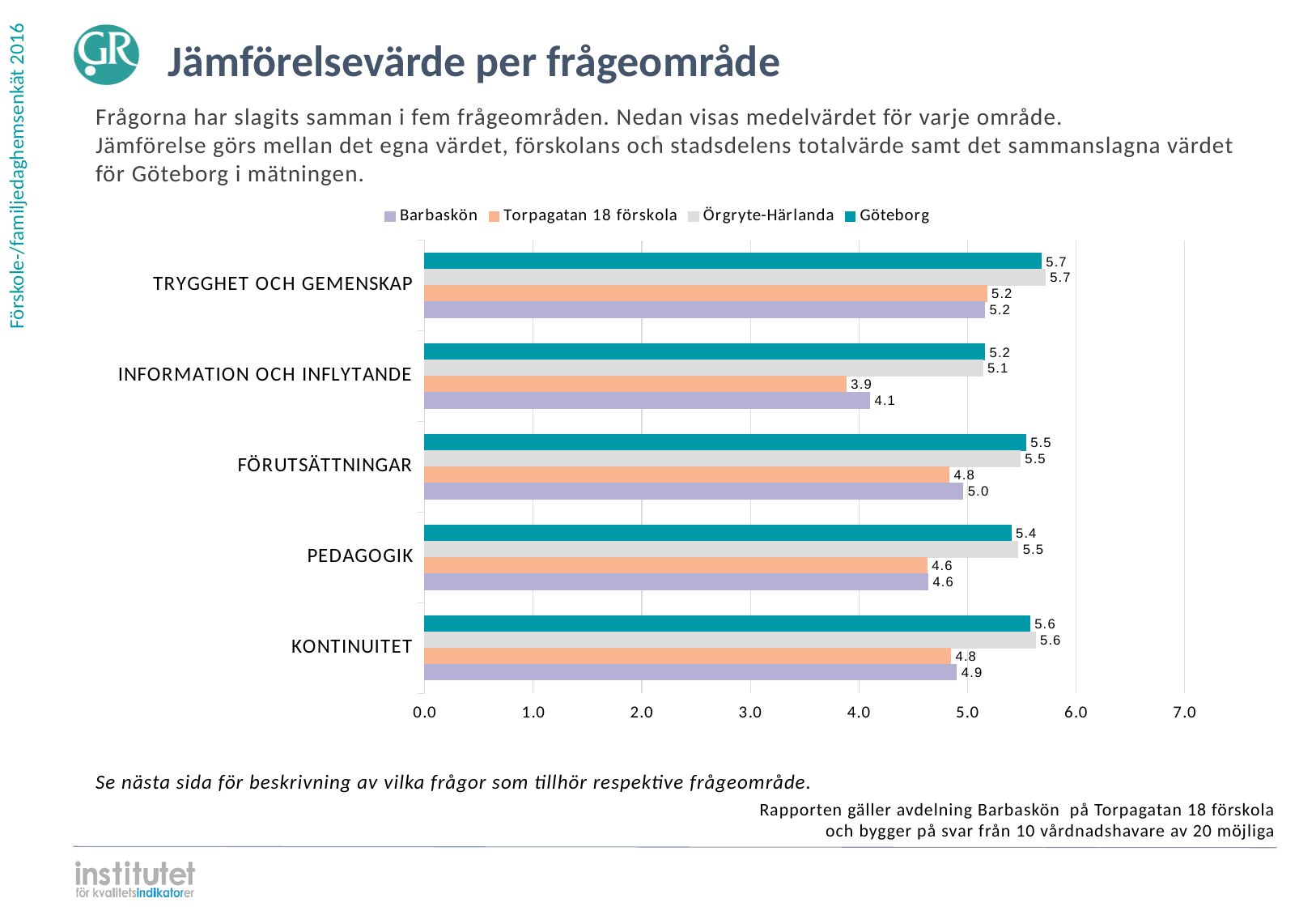
In which category does Barbaskön have its lowest value? INFORMATION OCH INFLYTANDE What is the value for Örgryte-Härlanda in the FÖRUTSÄTTNINGAR category? 5.5 How many question areas (categories) are shown on the chart? 5 What is the value for Barbaskön in the INFORMATION OCH INFLYTANDE category? 4.1 What is the value for Göteborg in the KONTINUITET category? 5.6 What kind of chart is shown on the slide? Bar chart What is the value for Torpagatan 18 förskola in the PEDAGOGIK category? 4.6 What is the difference between the Göteborg value and the Torpagatan 18 förskola value in the INFORMATION OCH INFLYTANDE category? 1.3 In the FÖRUTSÄTTNINGAR category, which is larger: the value for Barbaskön or the value for Torpagatan 18 förskola? Barbaskön How many series does the legend list? 4 Which series is shown in teal (dark green) on the chart? Göteborg In which category does Barbaskön have its highest value? TRYGGHET OCH GEMENSKAP